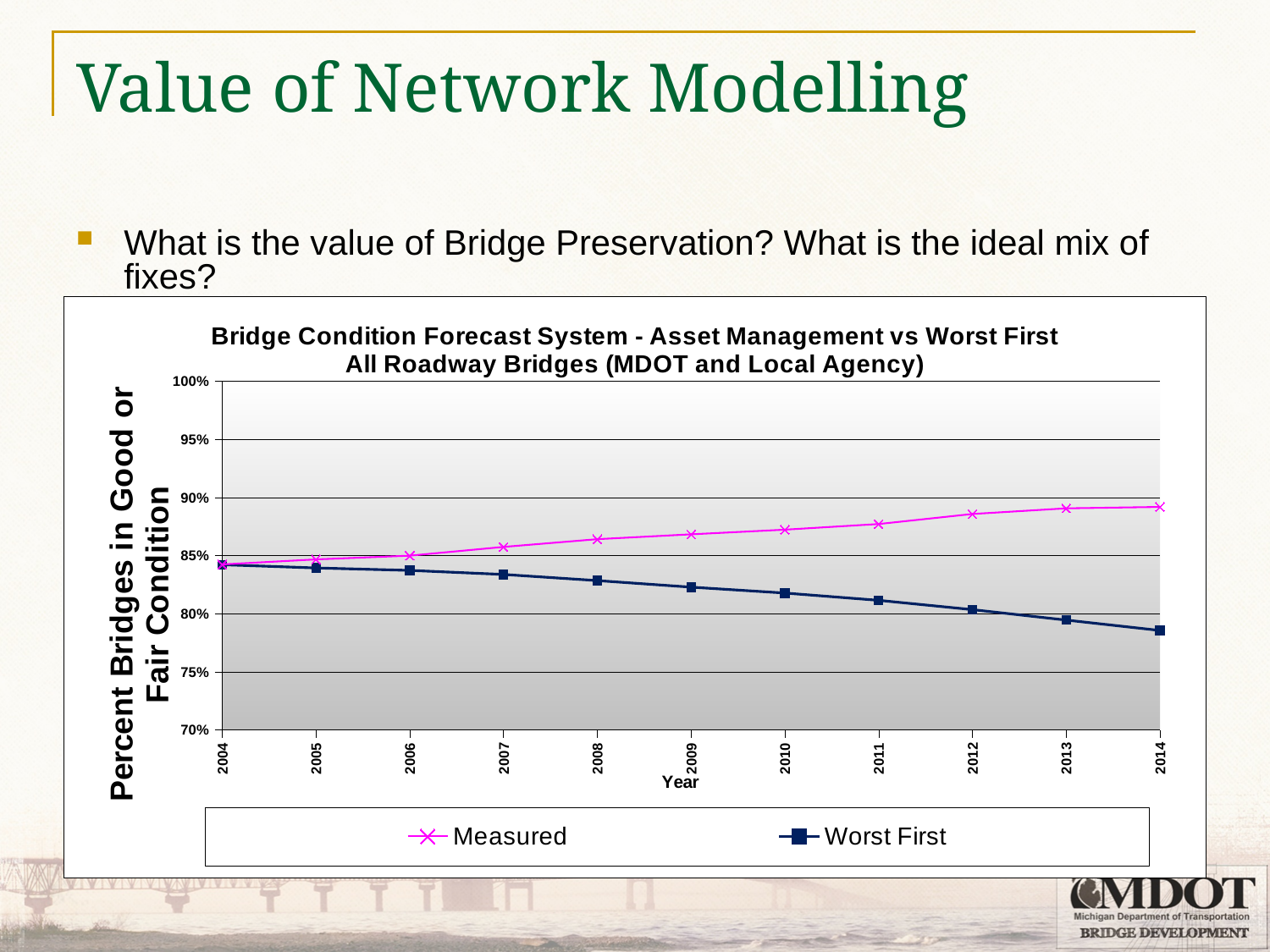
Is the value for Measured in 2014 greater or less than 90%? less In 2014, which series has the larger value, Measured or Worst First? Measured Does the Measured series rise or fall from 2004 to 2014? rise How many years are plotted along the x axis of the chart? 11 What kind of chart is shown on the slide? line chart In which year is the Worst First series at its lowest? 2014 Is the value for Worst First in 2014 greater or less than 80%? less Does the Worst First series rise or fall from 2004 to 2014? fall In which year is the Measured series at its highest? 2014 What are the two series named in the chart legend? Measured and Worst First Is the value for Measured in 2010 greater or less than 85%? greater How many series does the chart legend list? 2